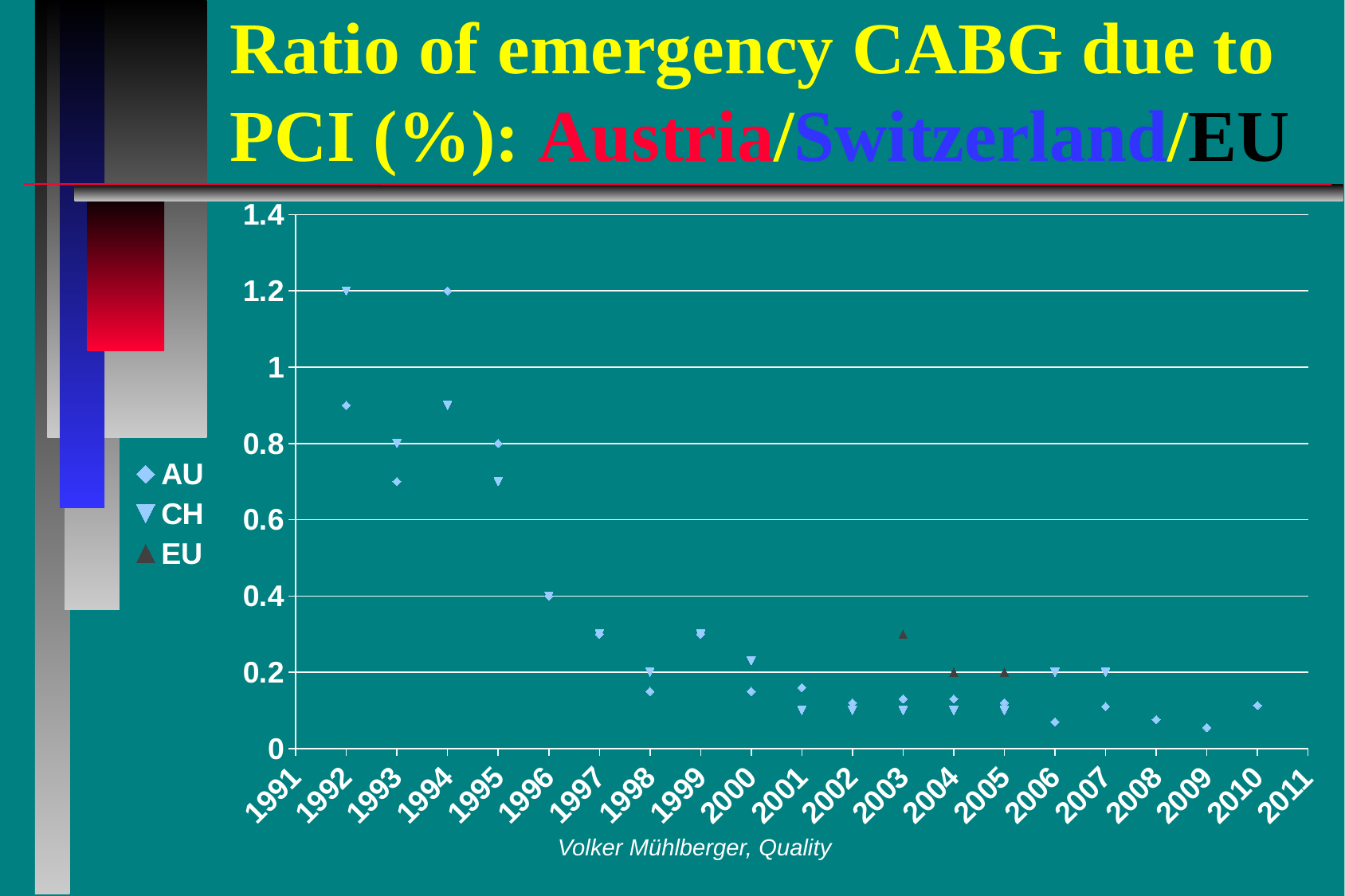
What is the value for EU in 2004? 0.2 What is the value for AU in 1994? 1.2 In which year is the AU series at its highest? 1994 What kind of chart is shown on the slide? scatter chart Is the value for EU in 2003 greater or less than 0.2? greater Do the AU values generally rise or fall from 1992 to 2010? fall How many series does the legend list? 3 Is the value for AU in 2009 greater or less than 0.2? less What is the value for CH in 1996? 0.4 Is the value for AU in 1992 greater or less than 0.8? greater Which series are listed in the legend? AU, CH, EU What is the value for CH in 1992? 1.2